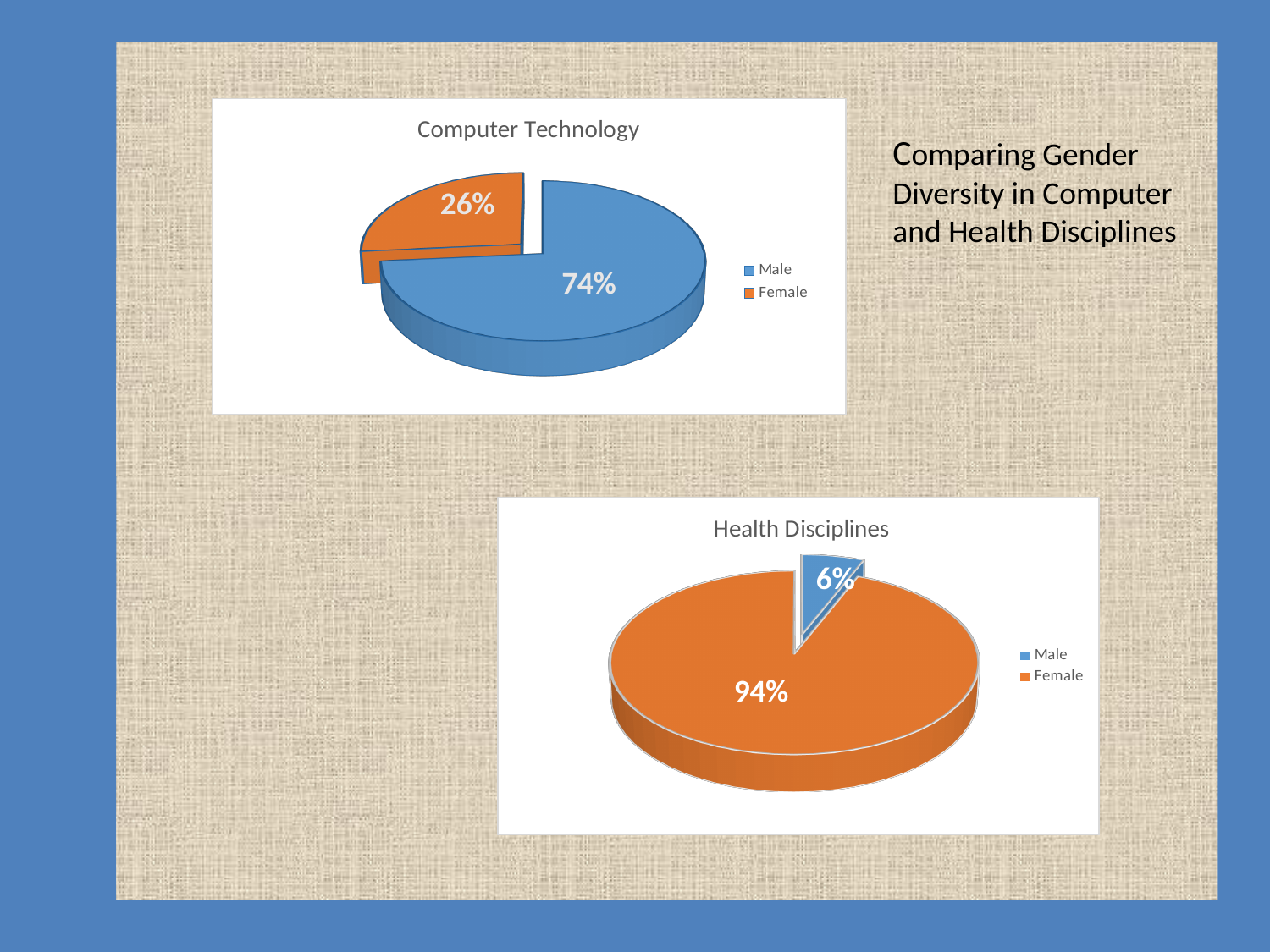
In the Computer Technology chart, what percentage is Male? 74% In the Computer Technology chart, what is the difference between the Male and Female percentages? 48% In the Health Disciplines chart, what is the difference between the Female and Male percentages? 88% What type of chart is the Health Disciplines chart? Pie chart In the Computer Technology chart, which category has the largest slice? Male How many slices does the Computer Technology pie chart have? 2 In the Health Disciplines chart, what percentage is Male? 6% In the Health Disciplines chart, which category has the smallest slice? Male In the Computer Technology chart, what colour represents Female? Orange In the Health Disciplines chart, which is larger, Male or Female? Female In the Health Disciplines chart, what percentage is Female? 94% In the Computer Technology chart, what percentage is Female? 26%